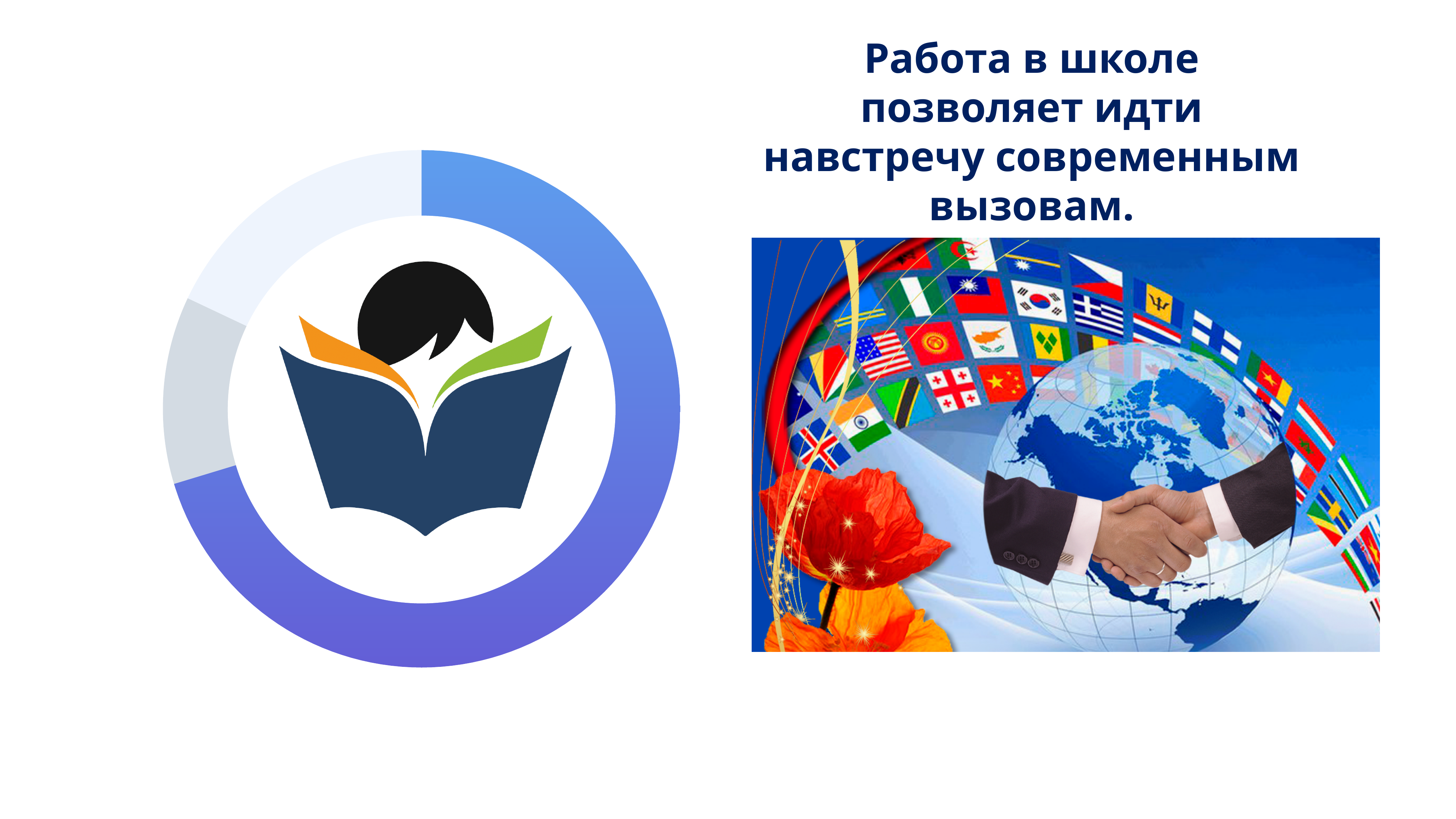
What kind of chart is shown on the left side of the slide? doughnut chart Which coloured segment of the doughnut chart on the left is the largest? the blue segment Does the doughnut chart on the left show any data labels or a legend? No How many segments does the doughnut chart on the left have? 3